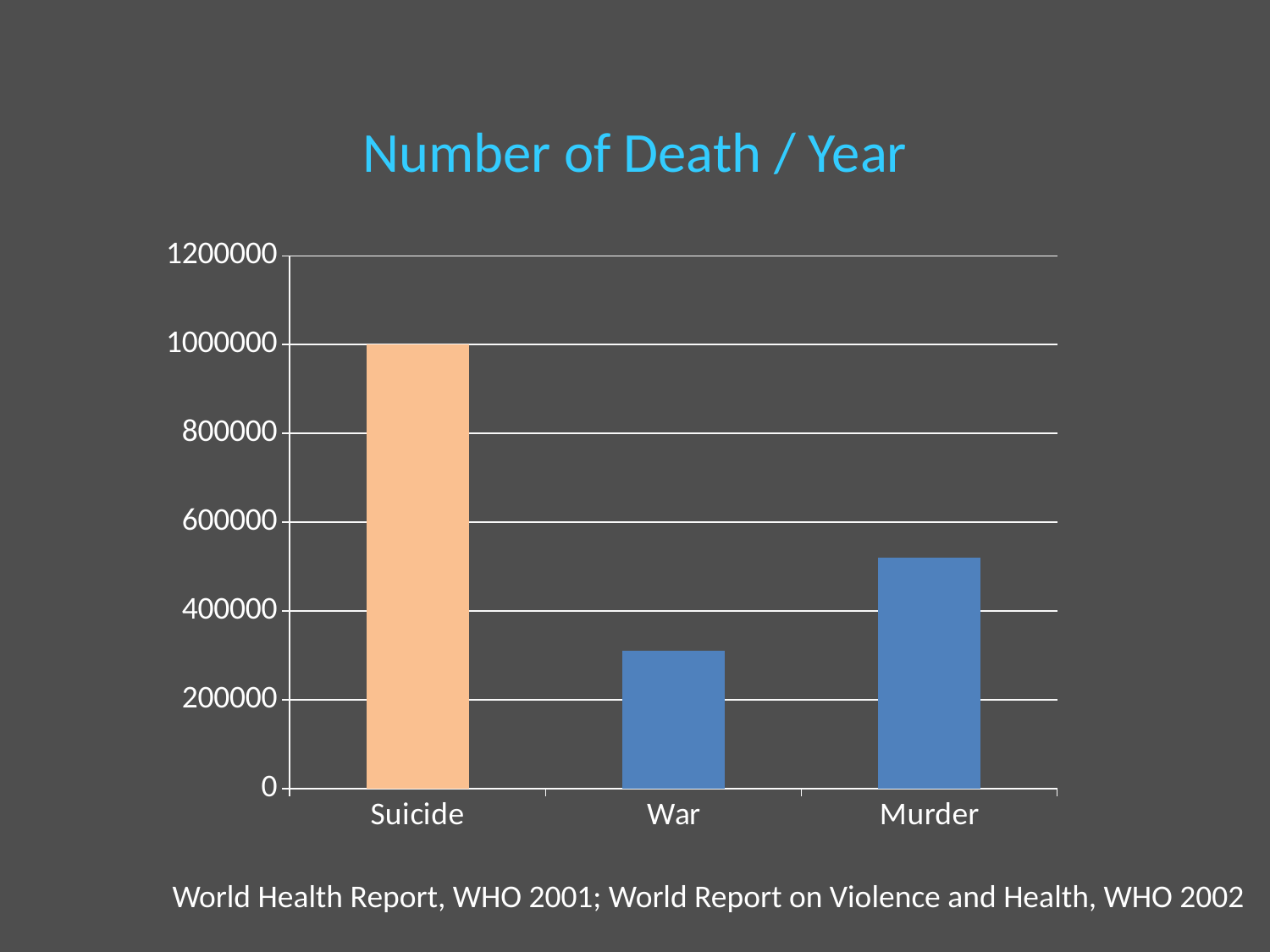
What kind of chart is shown on the slide? bar chart What is the title of the chart? Number of Death / Year How many categories are shown on the x axis of the chart? 3 Which category has the highest number of deaths per year? Suicide Which category has the lowest number of deaths per year? War Is the value for Murder greater or less than 400000? greater Is the value for War greater or less than 200000? greater Is the value for Murder greater or less than 600000? less What is the value for Suicide? 1000000 Which bar is shown in a different colour from the other two? Suicide Which is larger, the value for Murder or the value for War? Murder